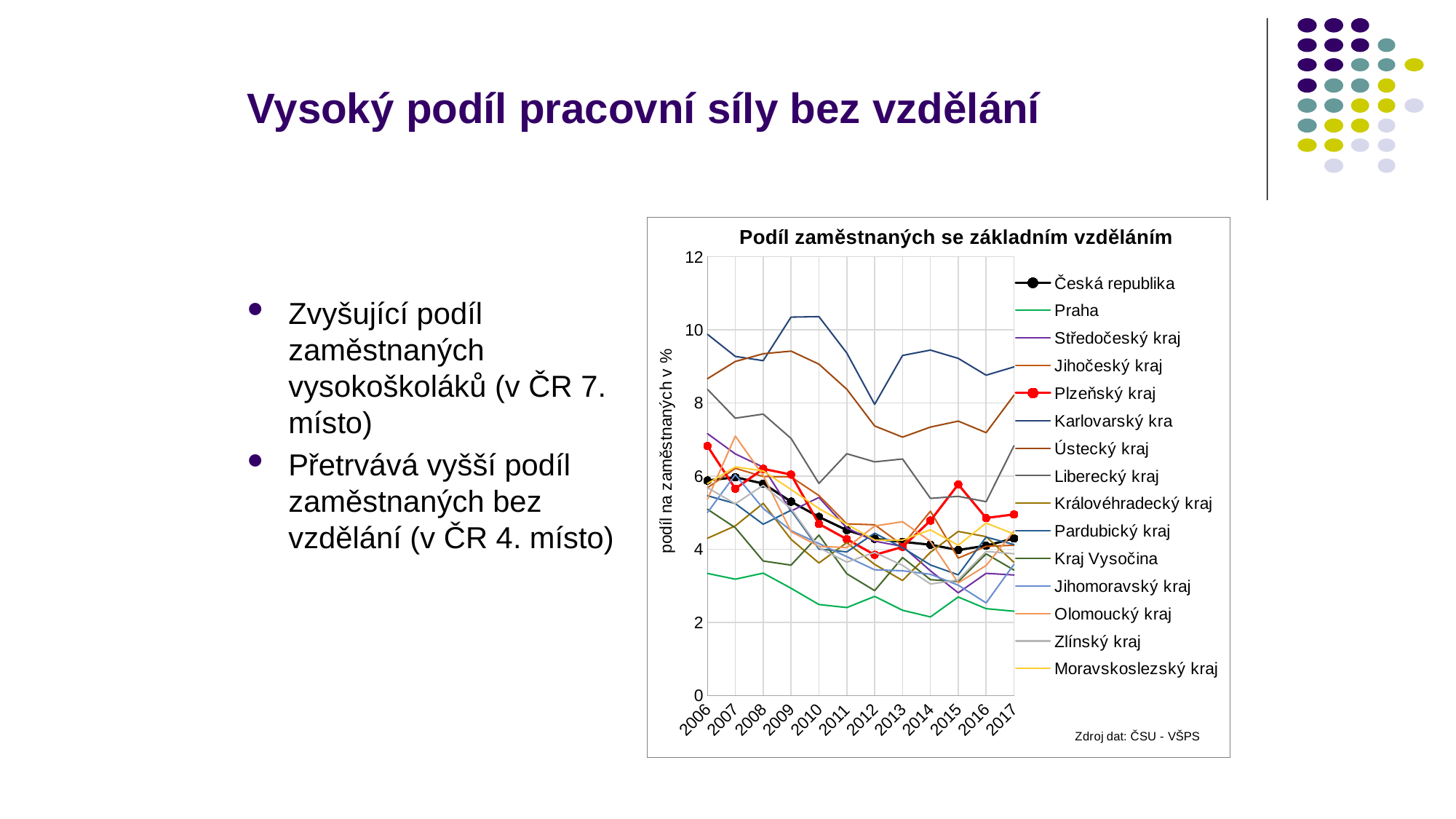
Is the value for Ústecký kraj in 2012 greater or less than 8? less Which is larger in 2010, the value for Karlovarský kraj or the value for Praha? Karlovarský kraj Which series has the highest value in 2006? Karlovarský kraj What kind of chart is shown on the slide? line chart Is the value for Praha in 2017 greater or less than 4? less What is the label of the y axis of the chart? podíl na zaměstnaných v % Is the value for Karlovarský kraj in 2006 greater or less than 8? greater How many years are shown on the x axis of the chart? 12 Does the value for Praha generally rise or fall from 2006 to 2017? fall What is the title of the chart? Podíl zaměstnaných se základním vzděláním Which series has the lowest value in 2017? Praha How many series does the chart legend list? 15